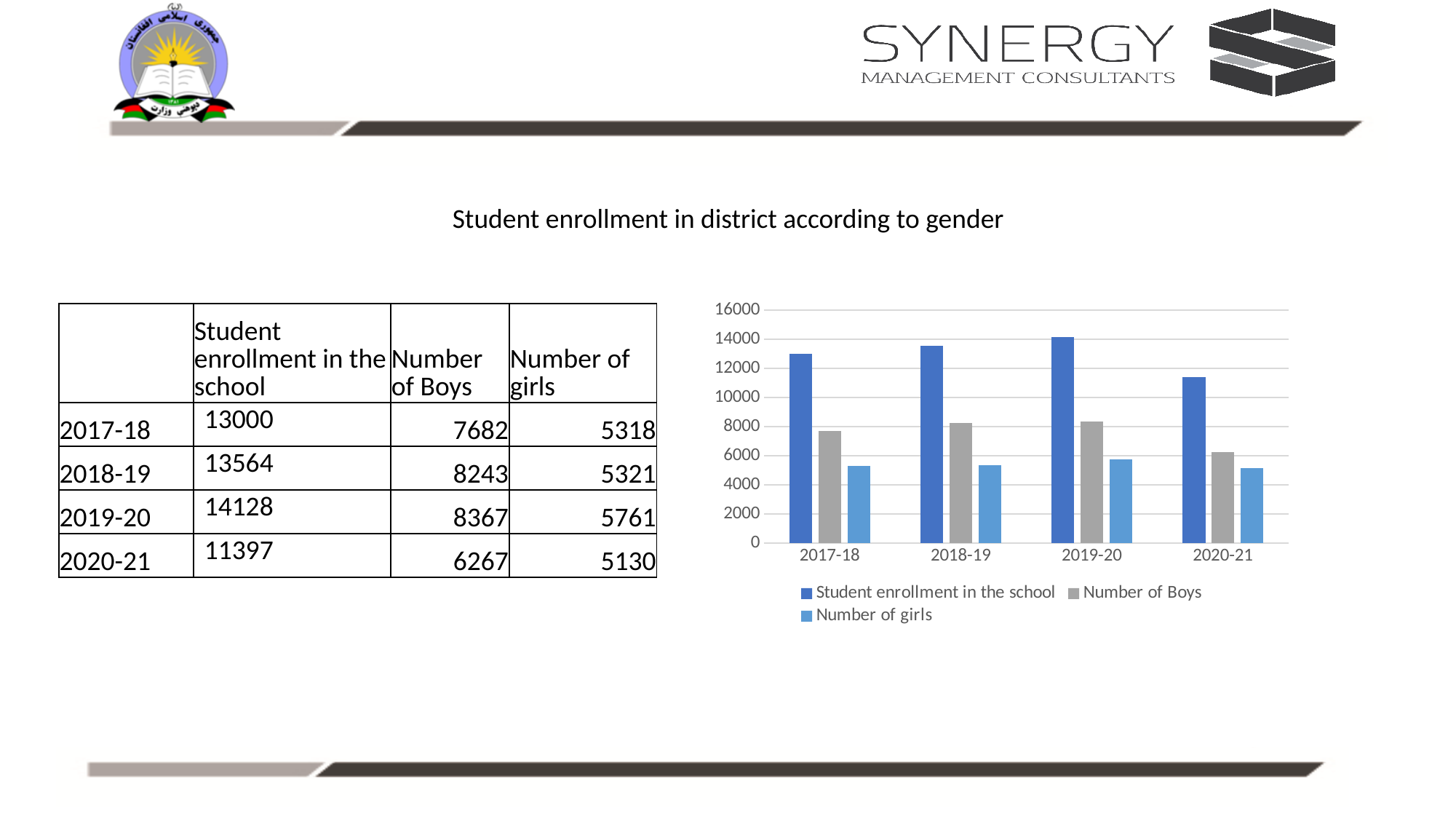
Does the student enrollment in the school rise or fall from 2019-20 to 2020-21? fall What is the difference between the number of boys and the number of girls in 2017-18? 2364 What is the number of girls for 2020-21? 5130 What kind of chart is shown on the slide? bar chart Which year has the lowest student enrollment in the school? 2020-21 Is the number of boys for 2019-20 greater or less than 8000? greater Which is larger in 2018-19, the number of boys or the number of girls? Number of Boys Which year has the highest student enrollment in the school? 2019-20 How many year categories are shown on the x axis of the chart? 4 How many series does the chart legend list? 3 What is the student enrollment in the school for 2019-20? 14128 Is the student enrollment in the school for 2020-21 greater or less than 12000? less